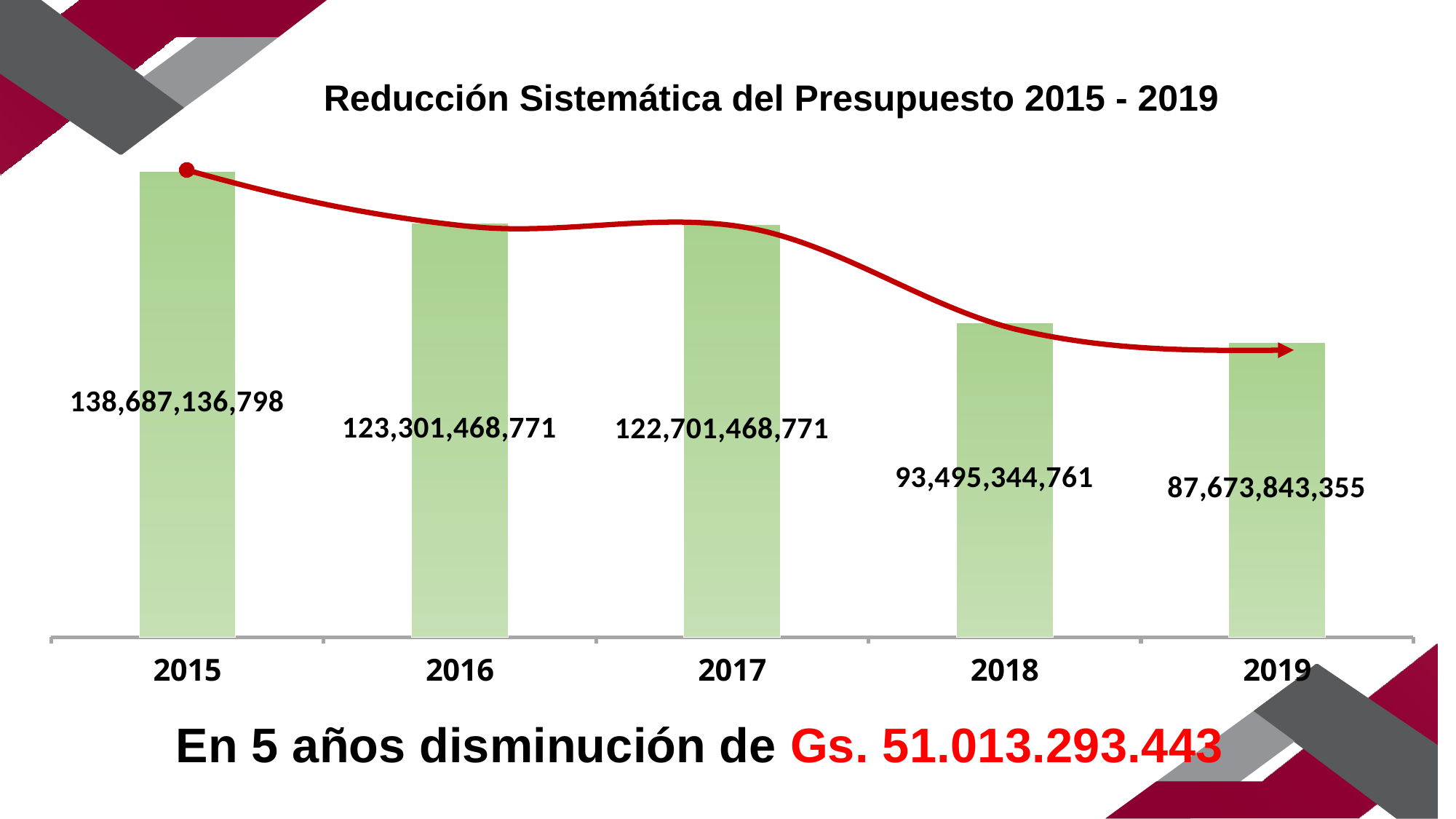
What is the title of the chart? Reducción Sistemática del Presupuesto 2015 - 2019 Which year has the highest value? 2015 What is the difference between the values for 2015 and 2019? 51,013,293,443 What is the value for 2018? 93,495,344,761 How many years are shown on the chart? 5 Which is larger, the value for 2016 or the value for 2017? 2016 What is the value for 2019? 87,673,843,355 Which year has the lowest value? 2019 What is the difference between the values for 2016 and 2017? 600,000,000 Do the values rise or fall from 2015 to 2019? Fall What is the value for 2015? 138,687,136,798 What kind of chart is shown on the slide? Bar chart